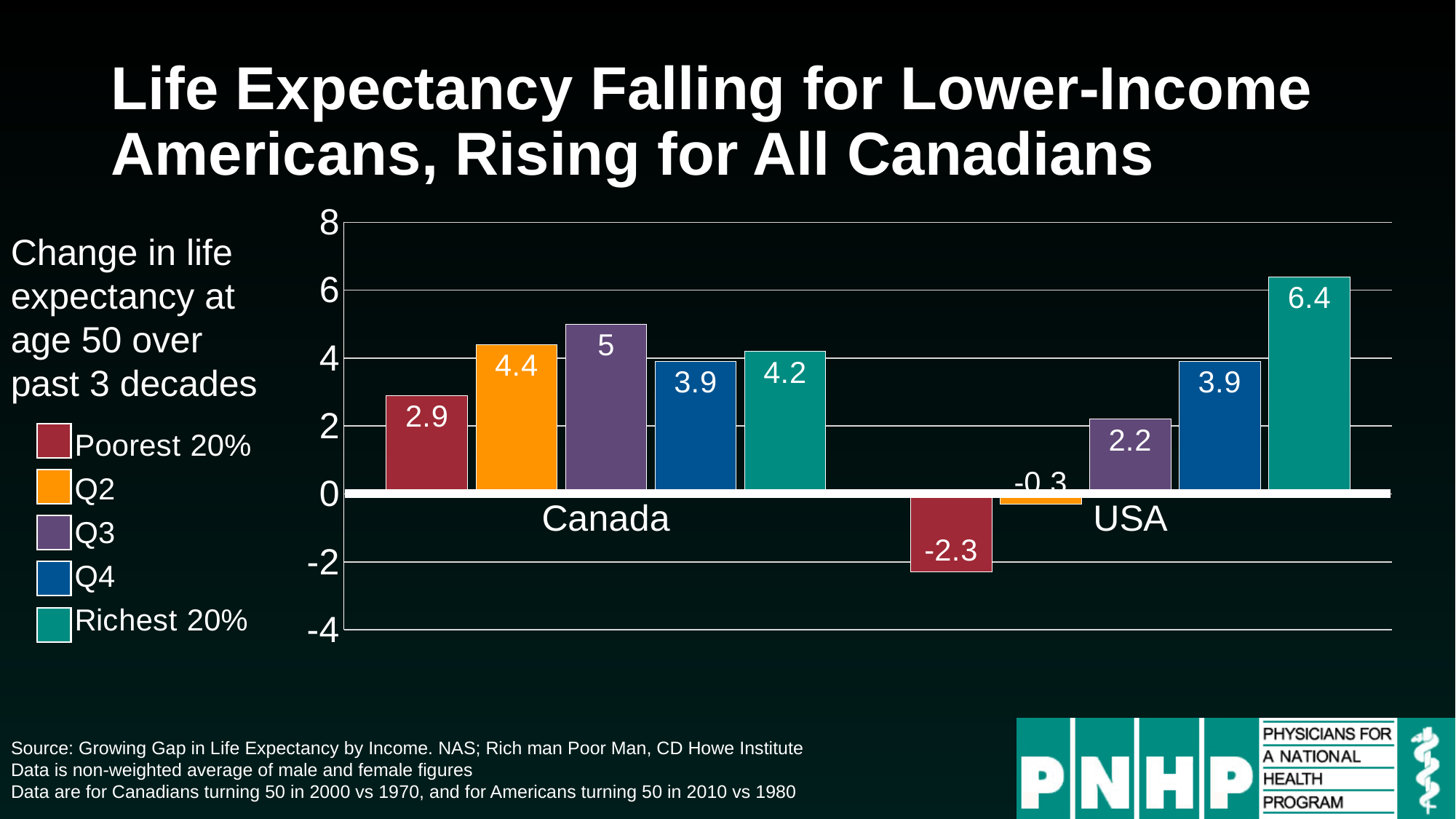
Which is larger: the Q4 value for Canada or the Q4 value for the USA? They are equal (3.9) What is the value for Q3 in Canada? 5 What is the value for the Poorest 20% in Canada? 2.9 Which income group has the highest value in Canada? Q3 Is the value for the Poorest 20% in the USA greater or less than 0? less How many series does the legend list? 5 What kind of chart is shown on the slide? Bar chart How many countries are shown on the x axis? 2 Which income group has the lowest value in the USA? Poorest 20% What is the value for Q2 in the USA? -0.3 What is the value for the Richest 20% in the USA? 6.4 What is the difference between the Richest 20% and the Poorest 20% values in the USA? 8.7